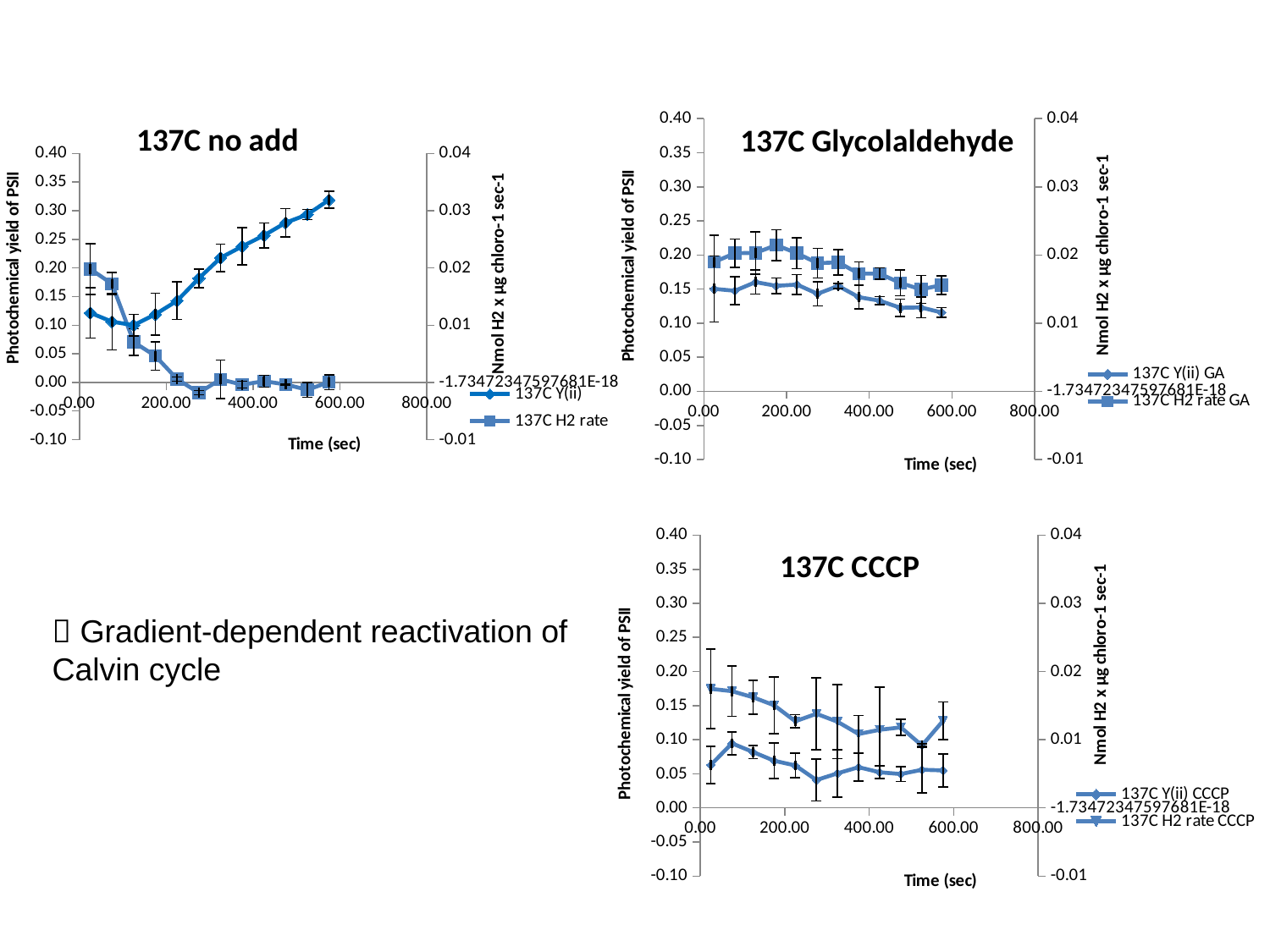
In the "137C CCCP" chart, which series is plotted higher at the start (near 25 sec): 137C Y(ii) CCCP or 137C H2 rate CCCP? 137C H2 rate CCCP What is the x-axis title of the "137C CCCP" chart? Time (sec) What is the left y-axis title of the "137C Glycolaldehyde" chart? Photochemical yield of PSII In the "137C no add" chart, which series is plotted higher at the end (near 575 sec): 137C Y(ii) or 137C H2 rate? 137C Y(ii) In the "137C CCCP" chart, is the first 137C Y(ii) CCCP value (near 25 sec) greater or less than 0.10 on the left axis? less How many charts are shown on the slide? 3 In the "137C no add" chart, does the 137C Y(ii) series rise or fall between 200 and 600 seconds? rise Across the three charts, which chart's Y(ii) series reaches the highest value? 137C no add In the "137C no add" chart, does the 137C H2 rate series rise or fall over time? fall In the "137C no add" chart, is the last 137C Y(ii) value (near 575 sec) greater or less than 0.30 on the left axis? greater What kind of chart is "137C no add"? line chart How many series does the legend of the "137C Glycolaldehyde" chart list? 2